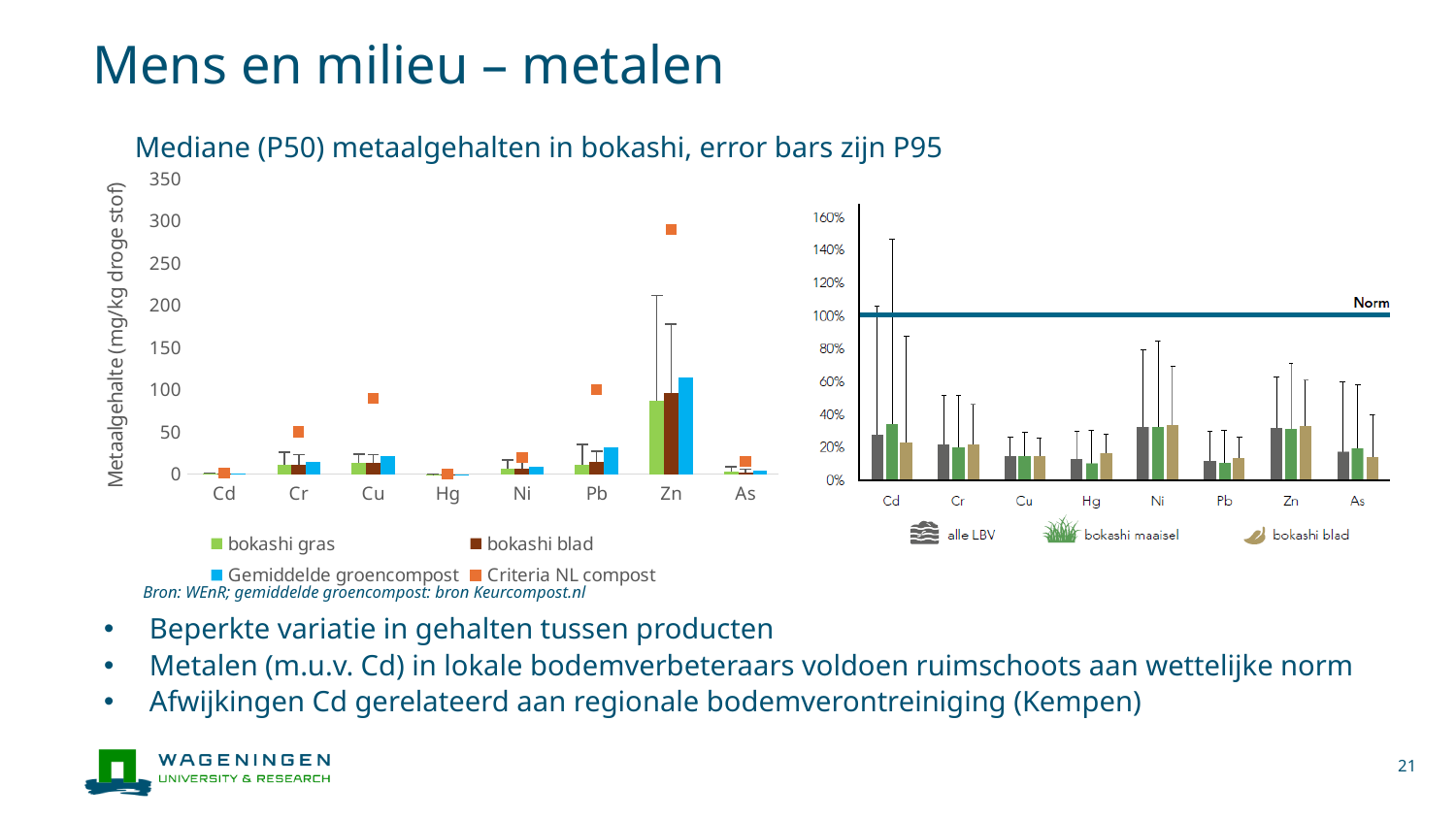
In the right chart, is the bokashi maaisel value for Cd greater or less than 20%? greater In the right chart, is the bokashi maaisel value for Hg greater or less than 20%? less How many series does the legend of the left chart list? 4 What is the y-axis label of the left chart? Metaalgehalte (mg/kg droge stof) In the right chart, at what percentage is the 'Norm' line drawn? 100% In the left chart, is the Gemiddelde groencompost value for Zn greater or less than 100? greater How many series does the legend of the right chart list? 3 In the left chart, is the bokashi gras value for Zn larger or smaller than the bokashi gras value for Cd? larger In the left chart, which metal has the highest values across the series? Zn What kind of chart is the left chart titled 'Mediane (P50) metaalgehalten in bokashi, error bars zijn P95'? bar chart How many metal categories are shown on the x axis of the left chart? 8